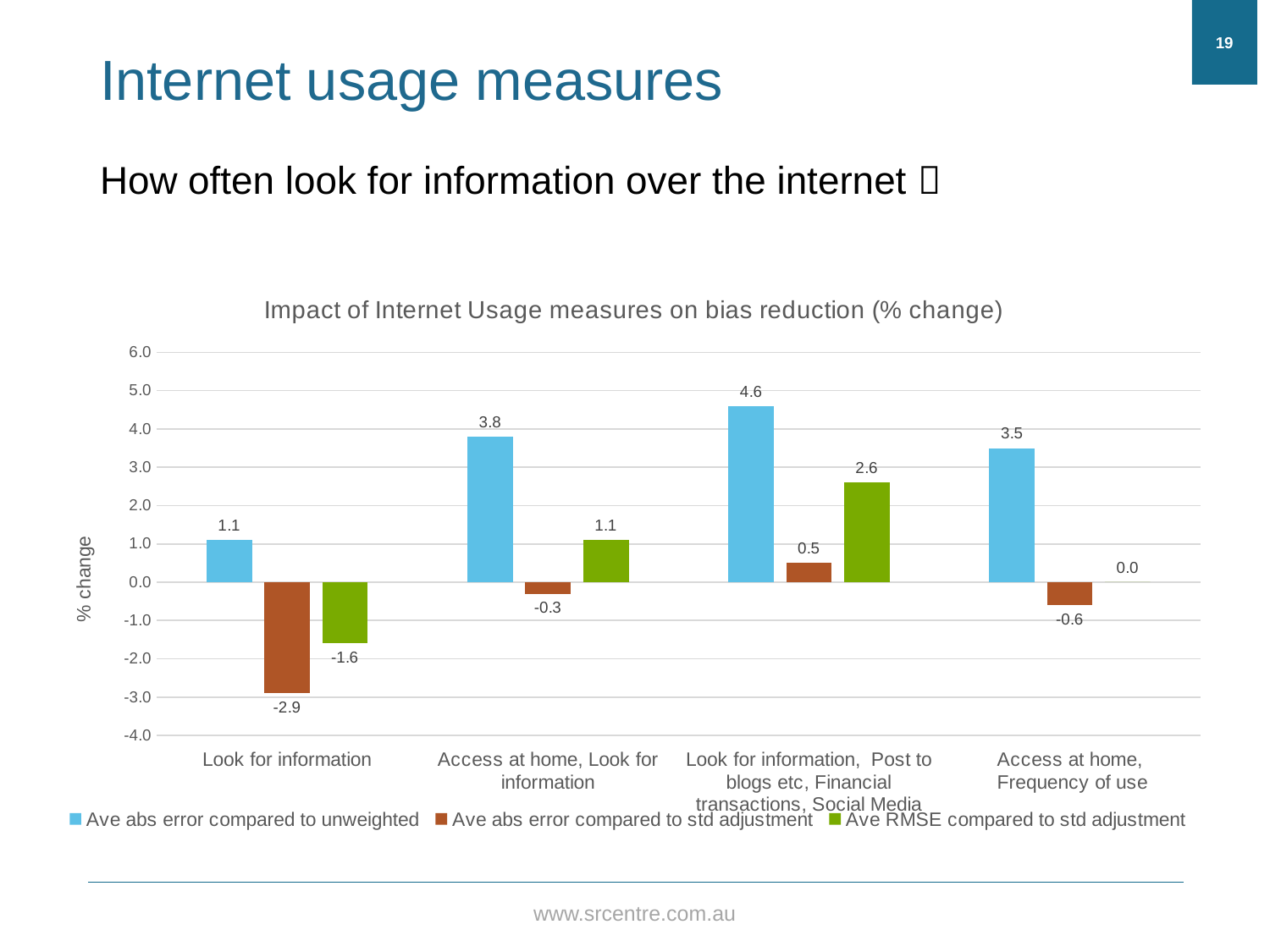
What is the title of the chart? Impact of Internet Usage measures on bias reduction (% change) Which category has the lowest value for 'Ave abs error compared to std adjustment'? Look for information Which category has the highest value for 'Ave abs error compared to unweighted'? Look for information, Post to blogs etc, Financial transactions, Social Media Which is larger: 'Ave RMSE compared to std adjustment' for 'Access at home, Look for information' or for 'Look for information, Post to blogs etc, Financial transactions, Social Media'? Look for information, Post to blogs etc, Financial transactions, Social Media What is the value of 'Ave abs error compared to unweighted' for 'Look for information, Post to blogs etc, Financial transactions, Social Media'? 4.6 What kind of chart is shown on the slide? Bar chart What is the label of the y axis? % change What is the difference between the 'Ave abs error compared to unweighted' values for 'Access at home, Look for information' and 'Look for information'? 2.7 How many series does the legend list? 3 How many categories are shown on the x axis? 4 What is the value of 'Ave RMSE compared to std adjustment' for 'Access at home, Frequency of use'? 0.0 What is the value of 'Ave abs error compared to std adjustment' for 'Look for information'? -2.9